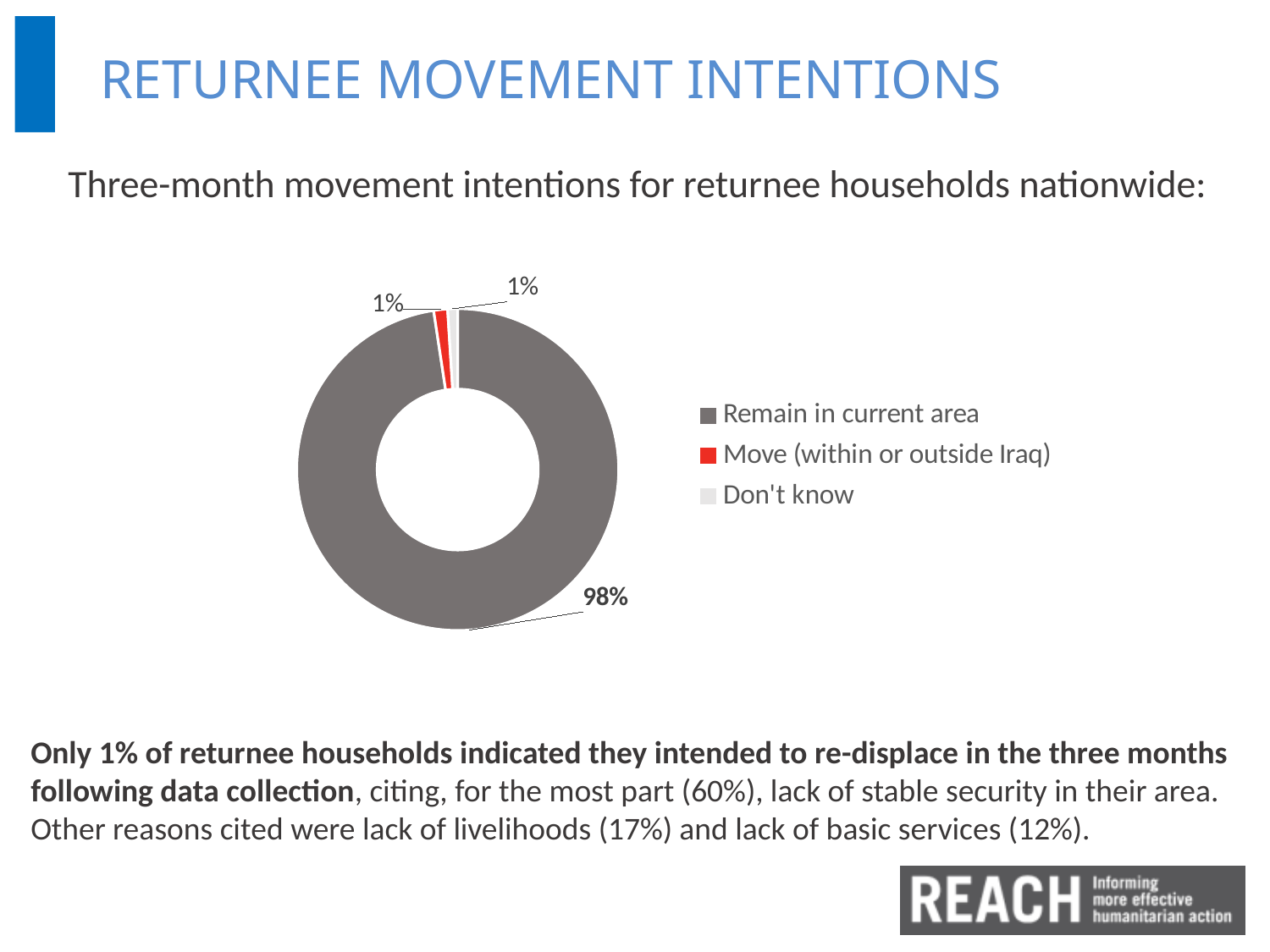
What percentage of returnee households intend to remain in their current area? 98% What kind of chart is shown on the slide? Pie (donut) chart How many categories are shown in the chart? 3 Is the value for 'Remain in current area' greater or less than 90%? greater What is the value shown for 'Don't know'? 1% What colour represents 'Move (within or outside Iraq)' in the chart? Red Which is larger: the share for 'Remain in current area' or the share for 'Don't know'? Remain in current area How many entries does the legend list? 3 What share of the pie is taken by 'Move (within or outside Iraq)'? 1% What is the difference in percentage points between 'Remain in current area' and 'Move (within or outside Iraq)'? 97 percentage points Which category has the largest slice of the chart? Remain in current area What colour represents 'Remain in current area' in the chart? Dark grey